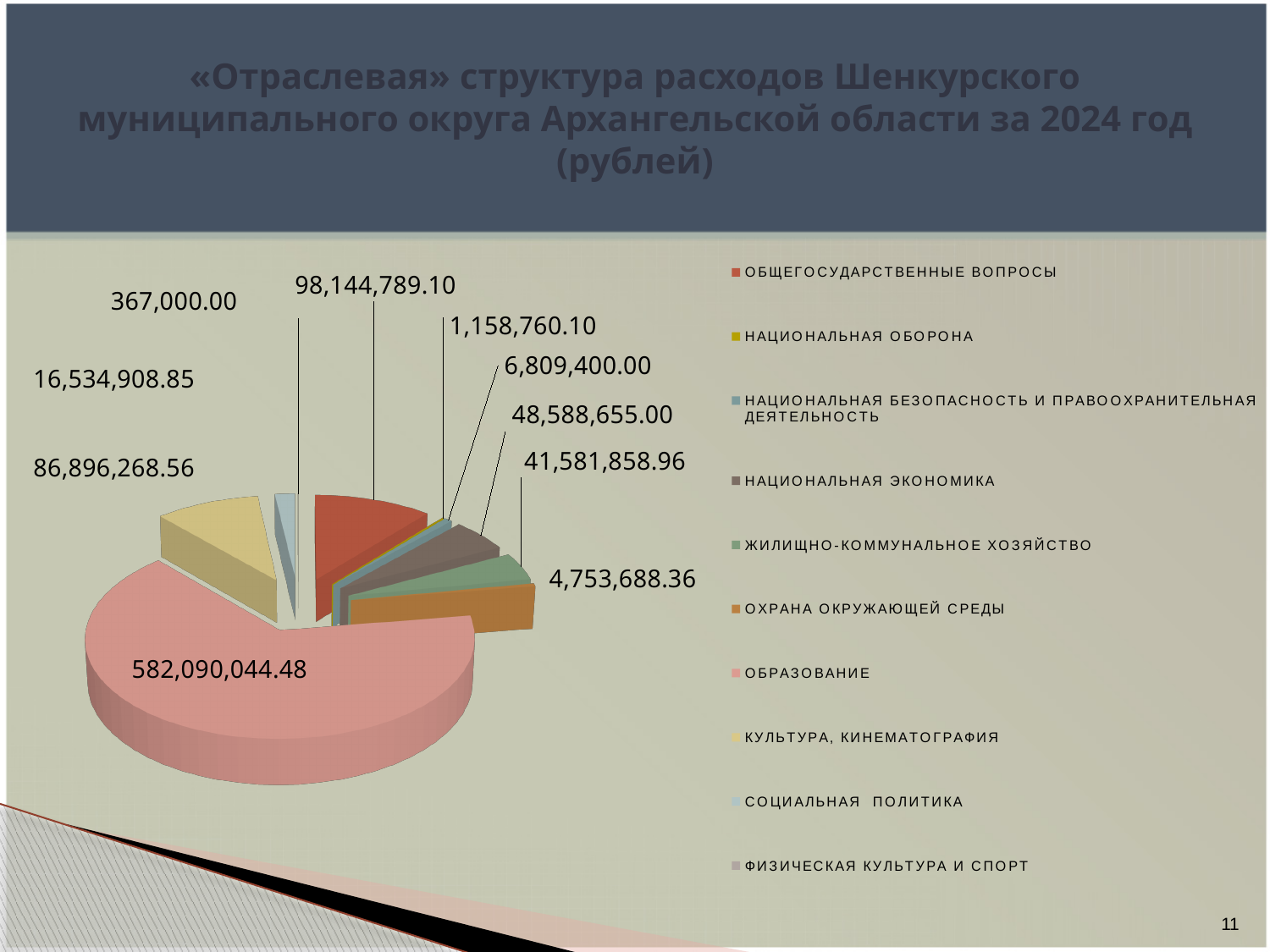
Which category has the largest share of expenditures? ОБРАЗОВАНИЕ What is the value for КУЛЬТУРА, КИНЕМАТОГРАФИЯ? 86,896,268.56 What is the value for НАЦИОНАЛЬНАЯ ОБОРОНА? 1,158,760.10 Which is larger: НАЦИОНАЛЬНАЯ ЭКОНОМИКА or ЖИЛИЩНО-КОММУНАЛЬНОЕ ХОЗЯЙСТВО? НАЦИОНАЛЬНАЯ ЭКОНОМИКА How many categories (slices) does the pie chart have? 10 What kind of chart is shown on the slide? Pie chart What is the value for ОБЩЕГОСУДАРСТВЕННЫЕ ВОПРОСЫ? 98,144,789.10 What is the difference between КУЛЬТУРА, КИНЕМАТОГРАФИЯ and СОЦИАЛЬНАЯ ПОЛИТИКА? 70,361,359.71 Which category has the smallest value? ФИЗИЧЕСКАЯ КУЛЬТУРА И СПОРТ What is the difference between ОБЩЕГОСУДАРСТВЕННЫЕ ВОПРОСЫ and НАЦИОНАЛЬНАЯ ЭКОНОМИКА? 49,556,134.10 What is the value for ОБРАЗОВАНИЕ? 582,090,044.48 What year does the chart title say the expenditure structure is for? 2024